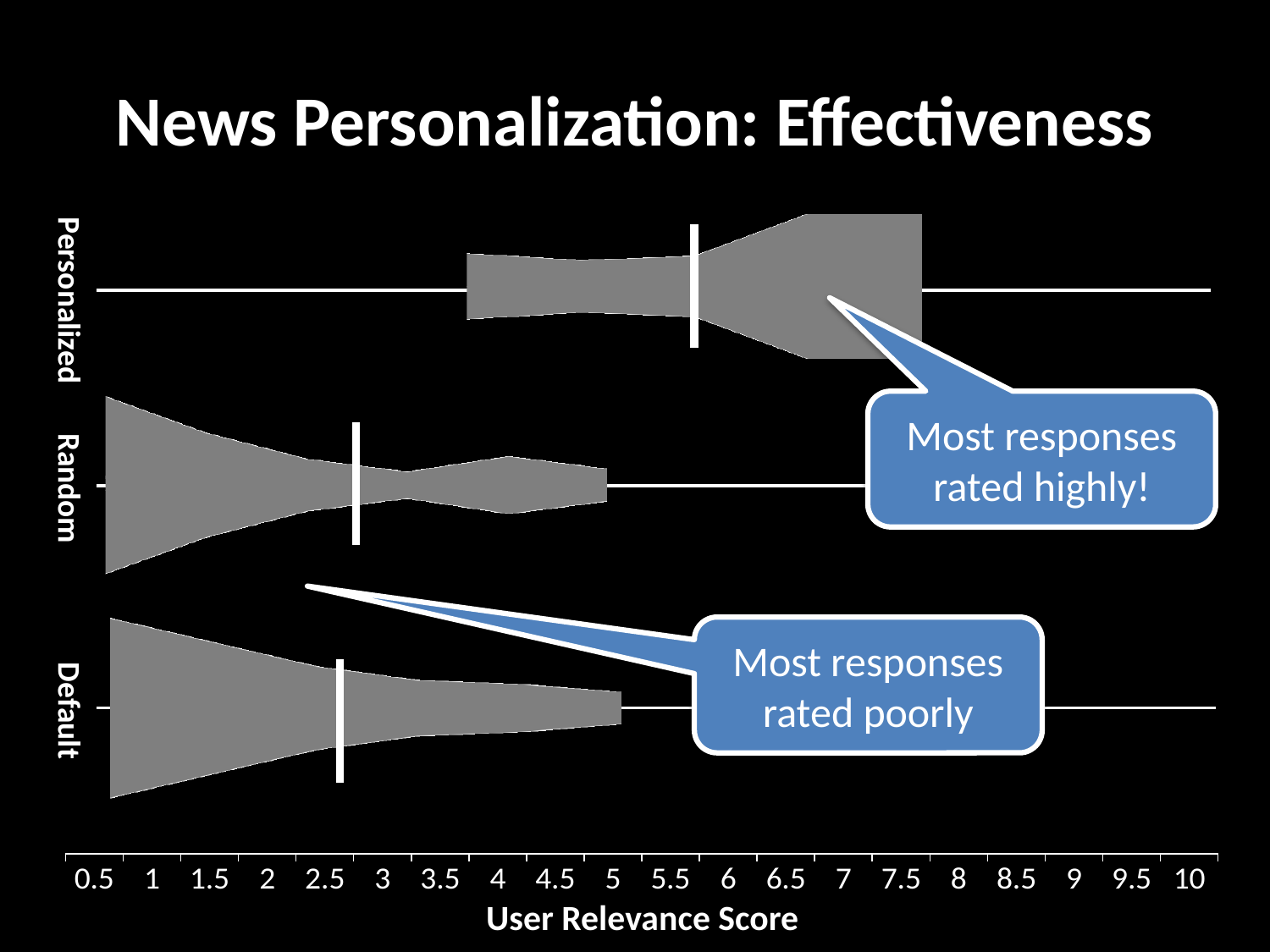
Is the median User Relevance Score for Random greater or less than 4? less Which category has the highest median User Relevance Score (white line)? Personalized What kind of chart is shown on the slide? Violin plot What is the highest tick value shown on the horizontal axis? 10 What is the title of the chart on the slide? News Personalization: Effectiveness How many categories are shown on the vertical axis of the chart? 3 Which has a larger median User Relevance Score, Personalized or Default? Personalized Is the median User Relevance Score for Personalized greater or less than 5? greater What is the lowest tick value shown on the horizontal axis? 0.5 What is the label of the horizontal axis? User Relevance Score Is the median User Relevance Score for Default greater or less than 3? less Which has a larger median User Relevance Score, Random or Personalized? Personalized